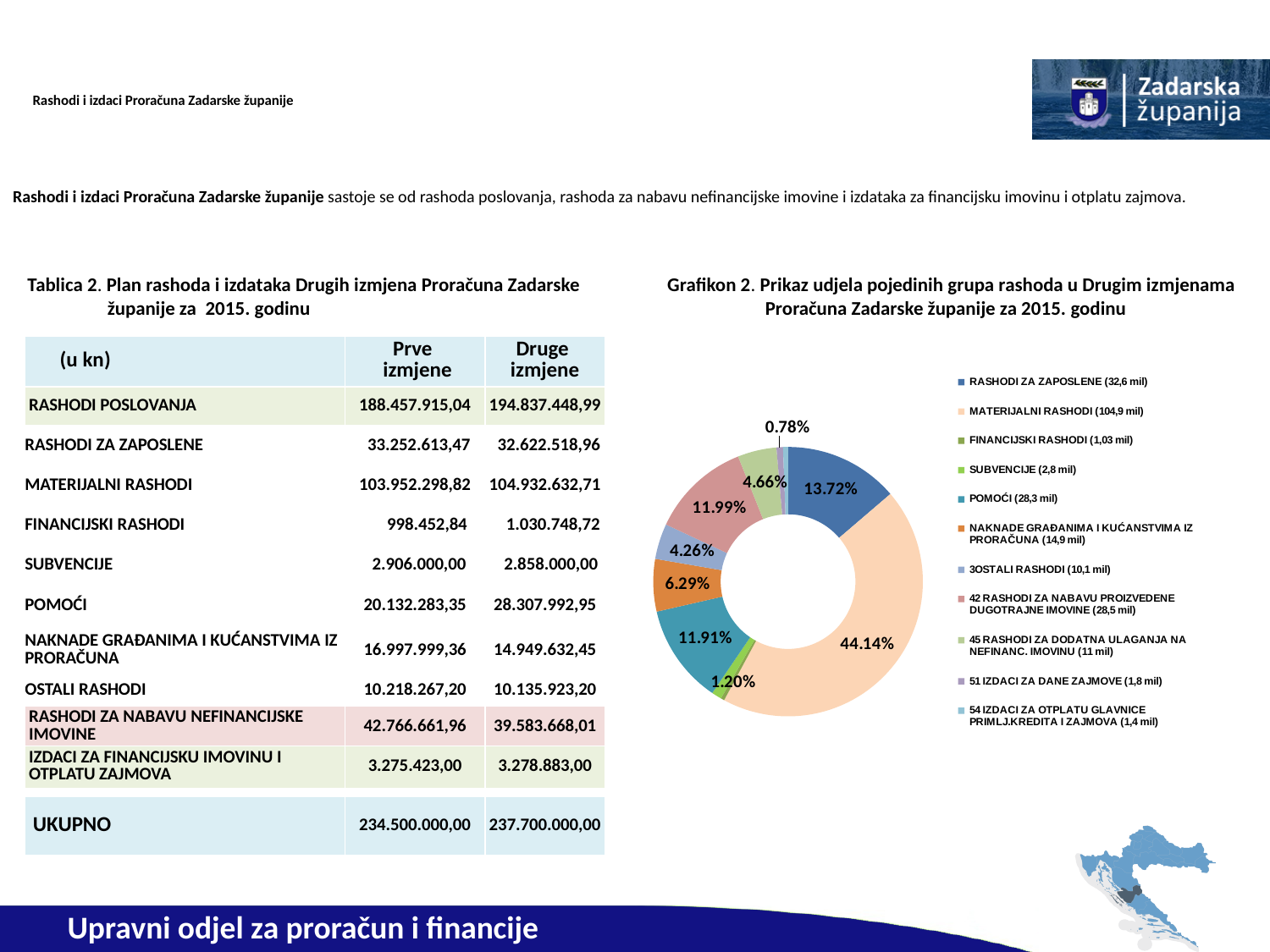
In Grafikon 2, which has the larger share: RASHODI ZA ZAPOSLENE or POMOĆI? RASHODI ZA ZAPOSLENE In Grafikon 2, what share is shown for RASHODI ZA ZAPOSLENE? 13.72% What is the title of the chart on the slide? Grafikon 2. Prikaz udjela pojedinih grupa rashoda u Drugim izmjenama Proračuna Zadarske županije za 2015. godinu In Grafikon 2, what share is shown for MATERIJALNI RASHODI? 44.14% In Grafikon 2, what share is shown for POMOĆI? 11.91% In Grafikon 2, which group of expenditures has the largest share? MATERIJALNI RASHODI In Grafikon 2, what amount in millions is given in the legend for MATERIJALNI RASHODI? 104,9 mil In Grafikon 2, what share is shown for SUBVENCIJE? 1.20% How many categories does the legend of Grafikon 2 list? 11 In Grafikon 2, what is the difference in percentage points between the share of MATERIJALNI RASHODI and the share of RASHODI ZA ZAPOSLENE? 30.42% What kind of chart is Grafikon 2? Pie (doughnut) chart In Grafikon 2, what share is shown for 51 IZDACI ZA DANE ZAJMOVE? 0.78%